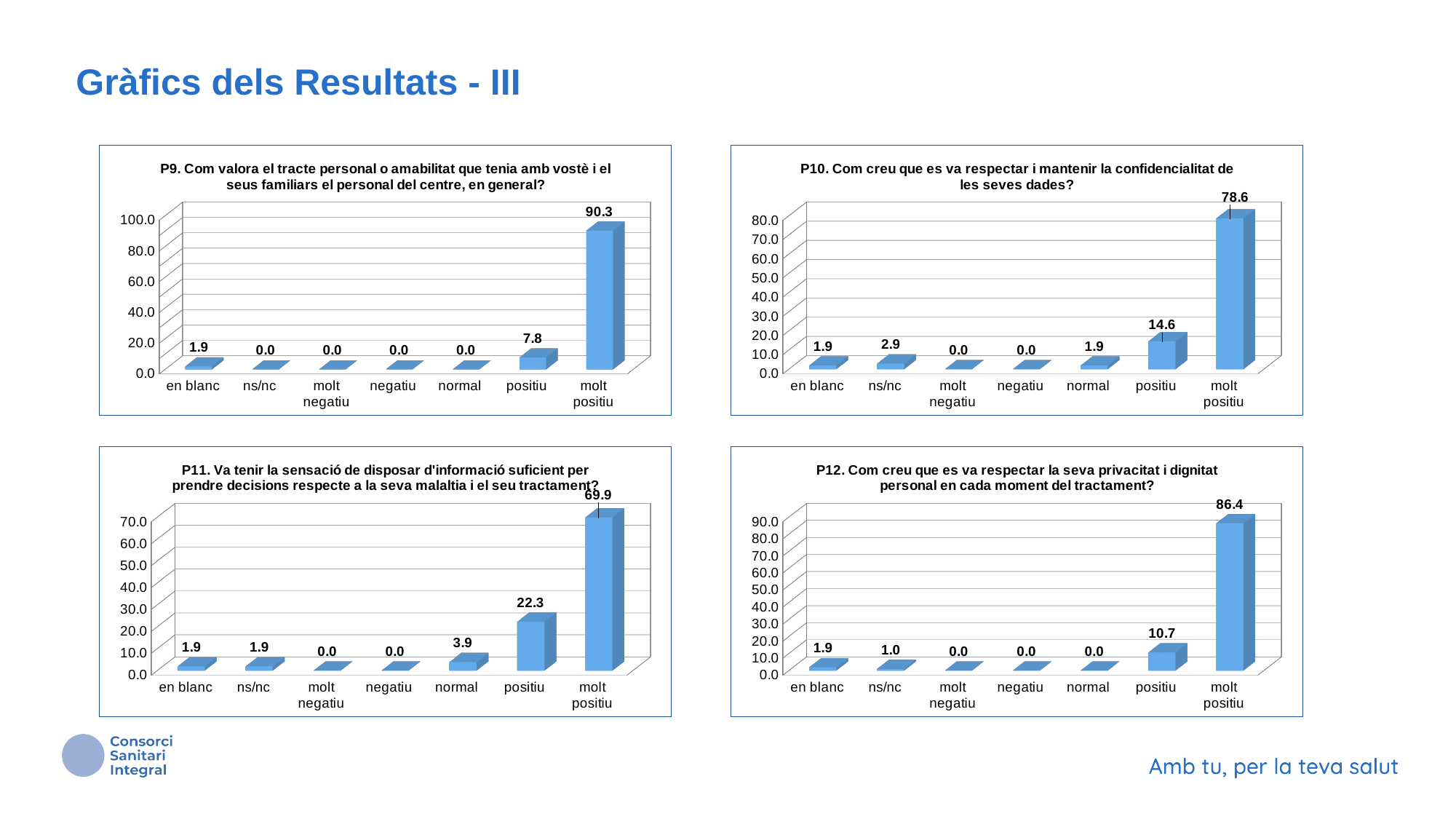
In the P12 chart (bottom right), what is the value for 'ns/nc'? 1.0 In the P11 chart (bottom left), which is larger, the value for 'positiu' or the value for 'normal'? positiu In the P11 chart (bottom left), which category has the highest value? molt positiu In the P12 chart (bottom right), what is the difference between 'molt positiu' and 'positiu'? 75.7 In the P10 chart (top right), what is the value for 'positiu'? 14.6 In the P10 chart (top right), what is the difference between 'molt positiu' and 'positiu'? 64.0 In the P9 chart (top left), is the value for 'molt positiu' greater or less than 80.0? greater How many categories are shown on the x axis of the P10 chart (top right)? 7 In the P11 chart (bottom left), what is the value for 'normal'? 3.9 In the P9 chart (top left), what is the value for 'molt positiu'? 90.3 What kind of chart is the P12 chart (bottom right)? bar chart How many charts are shown on the slide? 4